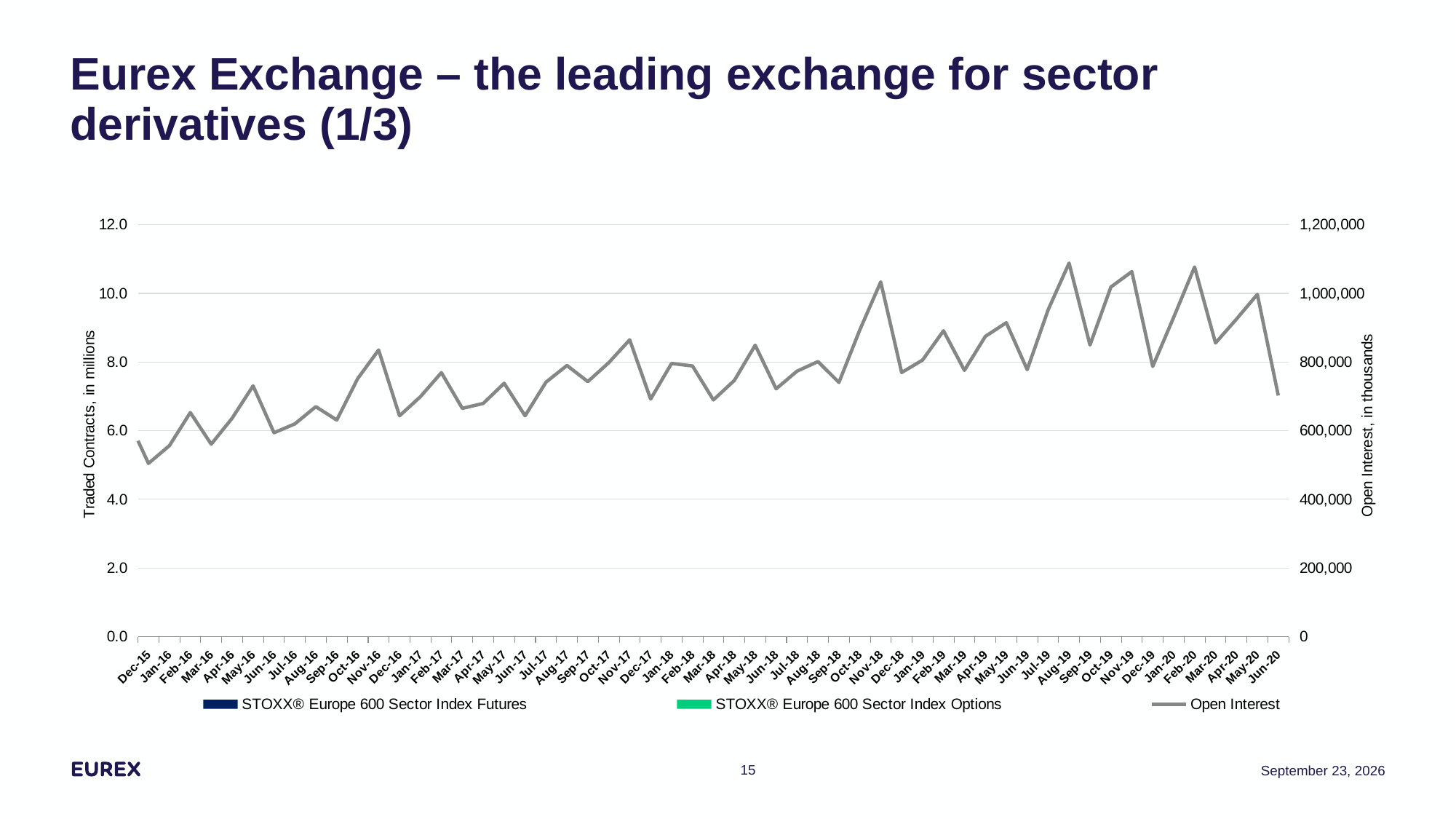
How many series does the legend list? 3 What is the title of the right-hand vertical axis? Open Interest, in thousands Is the Open Interest value for Jan-16 greater or less than 600,000? less What kind of chart is plotted on the slide? line chart Which has the larger Open Interest value, May-20 or Jun-20? May-20 Which month has the lowest Open Interest value on the chart? Dec-15 How many months are shown on the x axis, from Dec-15 to Jun-20? 55 Is the Open Interest value for Feb-20 greater or less than 1,000,000? greater What is the title of the left-hand vertical axis? Traded Contracts, in millions Is the Open Interest value for Aug-19 greater or less than 1,000,000? greater Does the Open Interest line generally rise or fall from Dec-15 to Aug-19? rise